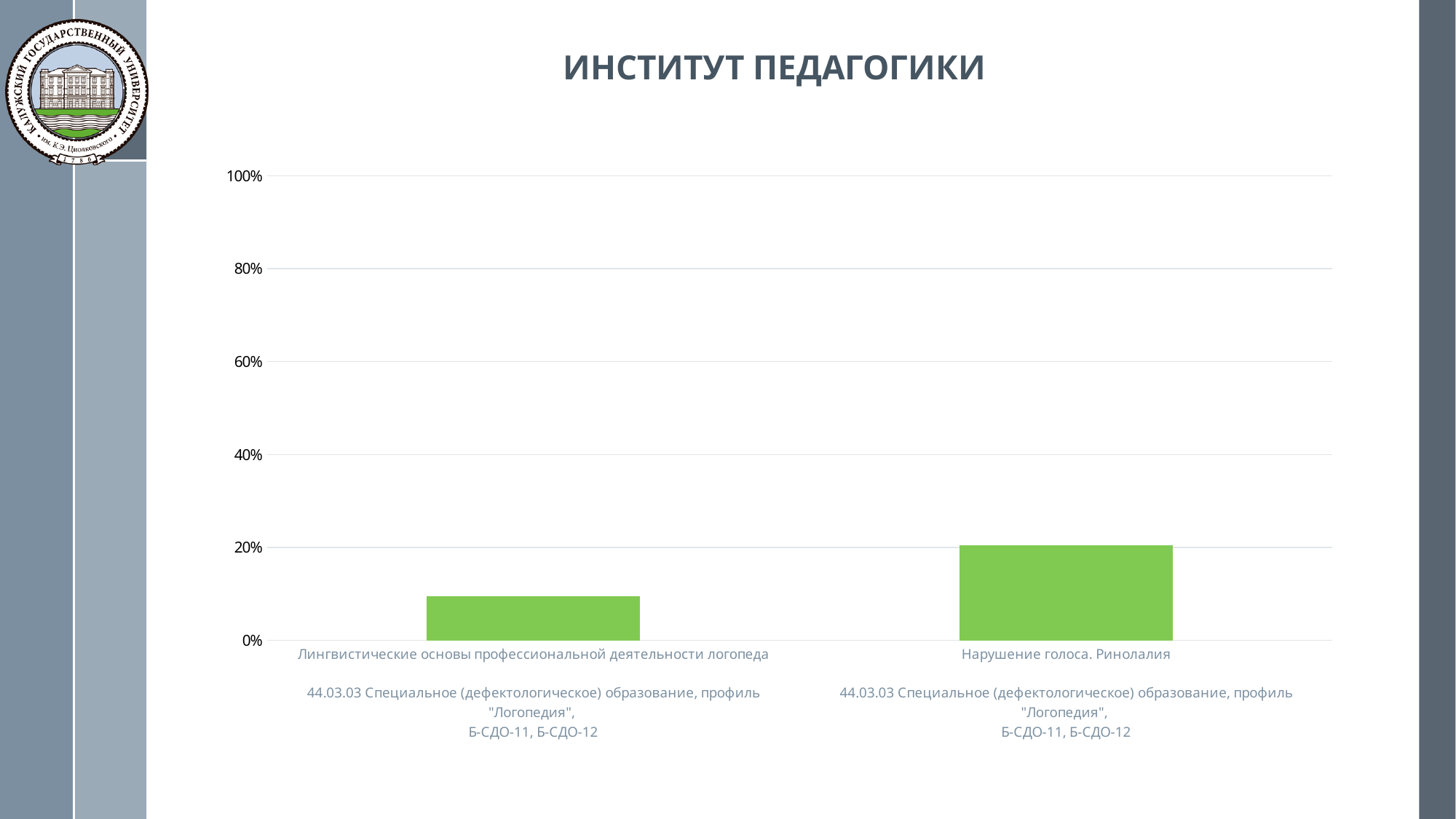
Which category has the highest value? Нарушение голоса. Ринолалия Do the values rise or fall from left to right across the categories? rise What is the title shown above the chart? ИНСТИТУТ ПЕДАГОГИКИ Is the value for "Лингвистические основы профессиональной деятельности логопеда" greater or less than 40%? less Which category has the lowest value? Лингвистические основы профессиональной деятельности логопеда Is the value for "Нарушение голоса. Ринолалия" greater or less than 40%? less Is the value for "Лингвистические основы профессиональной деятельности логопеда" greater or less than 20%? less What colour are the bars in the chart? green How many categories (bars) does the chart show? 2 Which is larger: the value for "Лингвистические основы профессиональной деятельности логопеда" or the value for "Нарушение голоса. Ринолалия"? Нарушение голоса. Ринолалия What kind of chart is shown on the slide? bar chart